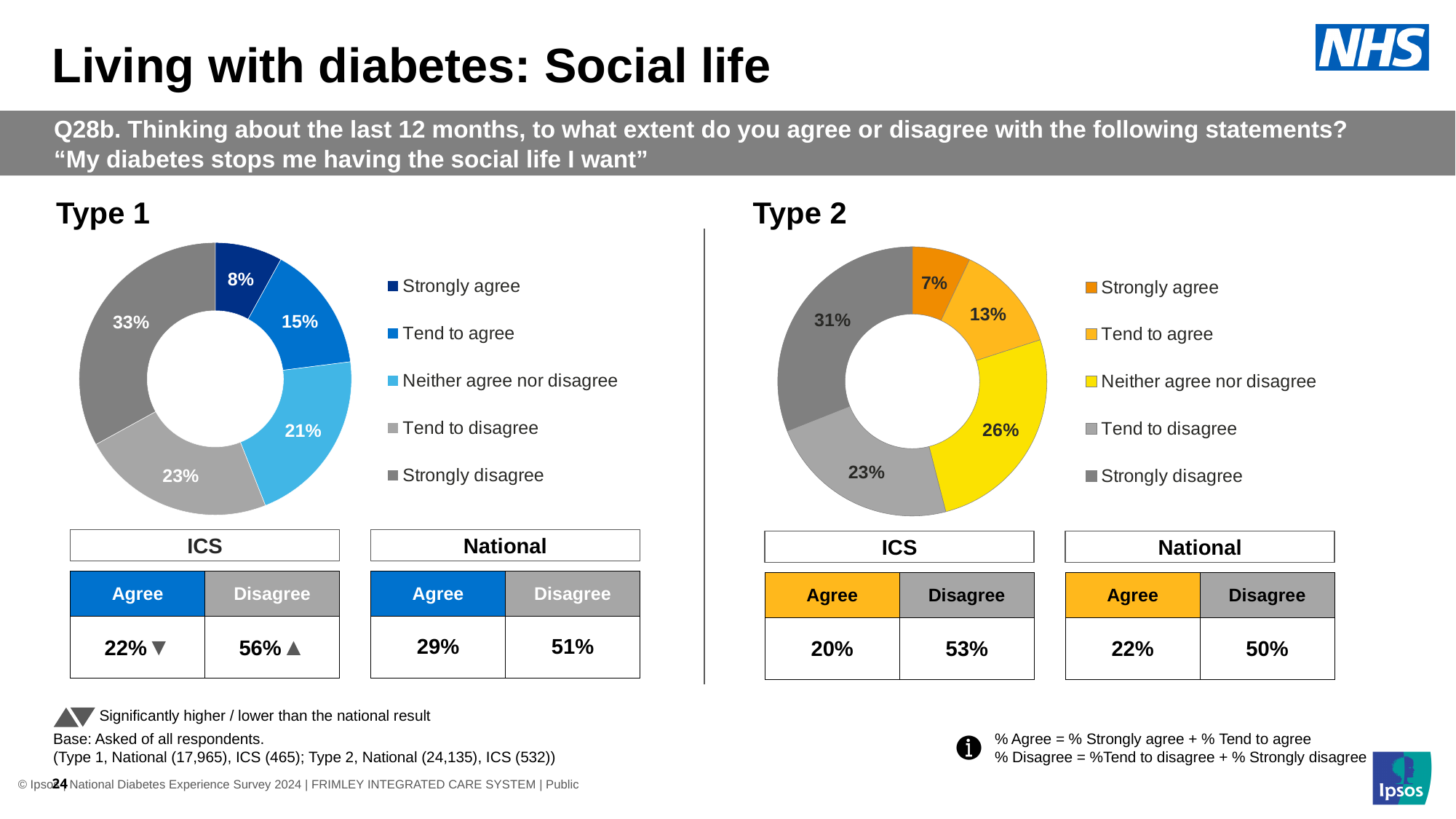
In the Type 2 chart, which is larger: 'Tend to agree' or 'Tend to disagree'? Tend to disagree In the Type 2 chart, what percentage of respondents said 'Neither agree nor disagree'? 26% What kind of chart is used for the Type 2 data? Doughnut chart In the Type 1 chart, what percentage of respondents said 'Strongly agree'? 8% What colour is used for the 'Neither agree nor disagree' segment in the Type 2 chart? Yellow How many response categories does the Type 1 chart show? 5 In the Type 2 chart, what is the combined share of 'Strongly agree' and 'Tend to agree'? 20% In the Type 1 chart, what is the difference between the 'Strongly disagree' share and the 'Tend to disagree' share? 10 percentage points In the Type 2 chart, which response category has the smallest share? Strongly agree In the Type 1 chart, what percentage of respondents said 'Tend to agree'? 15% In the Type 1 chart, which response category has the largest share? Strongly disagree In the Type 2 chart, what percentage of respondents said 'Strongly disagree'? 31%